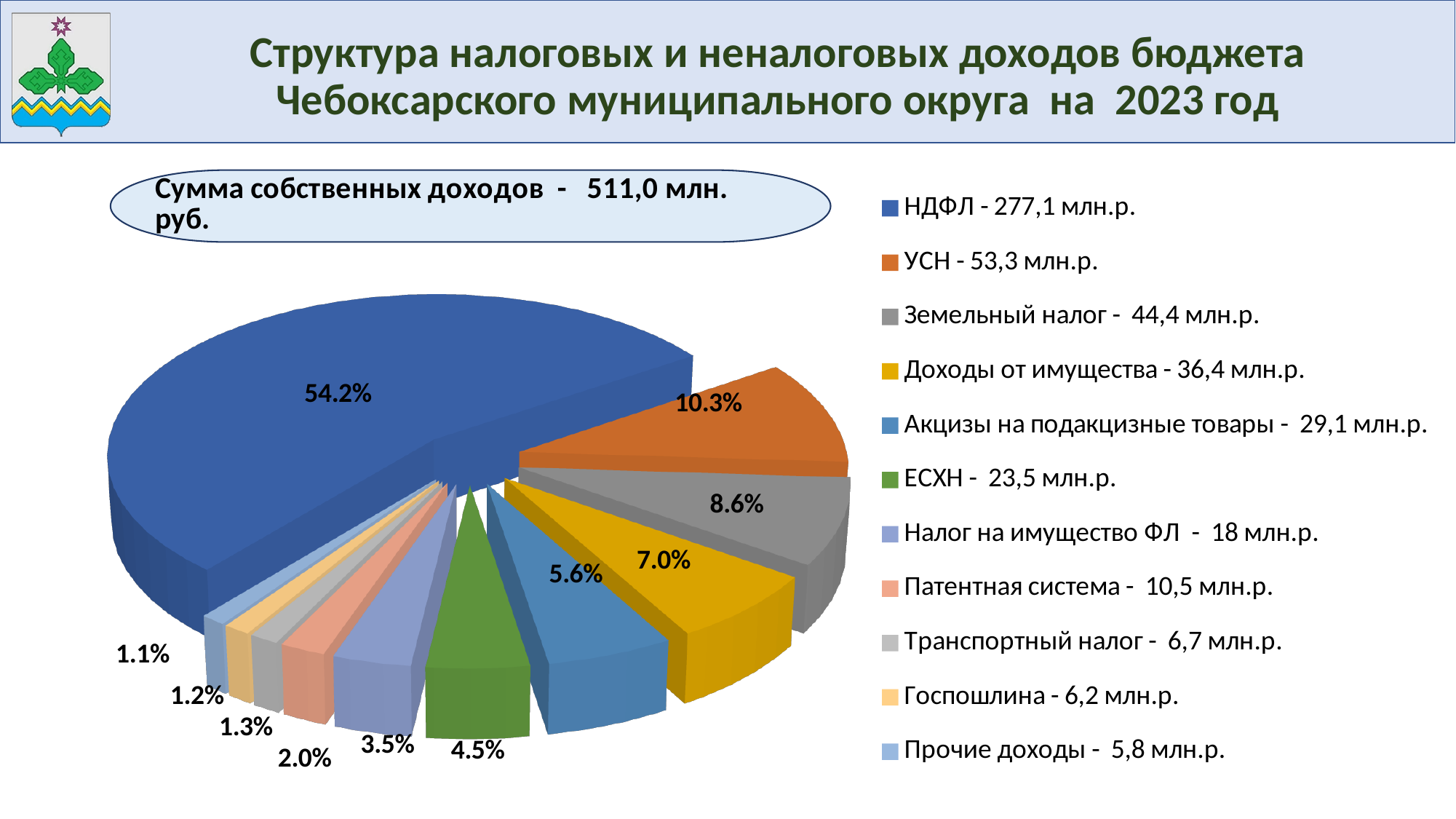
What is the difference between the values for НДФЛ and УСН shown in the legend? 223,8 млн.р. Which category has the smallest share of the pie? Прочие доходы According to the legend, what is the value for Акцизы на подакцизные товары? 29,1 млн.р. What kind of chart is shown on the slide? pie chart What total sum of own revenues is stated on the slide? 511,0 млн. руб. Which is larger, the share for Доходы от имущества or the share for Налог на имущество ФЛ? Доходы от имущества What share of the pie does УСН account for? 10.3% Which category has the largest share of the pie? НДФЛ How many slices does the pie chart have? 11 What share of the pie does ЕСХН account for? 4.5% According to the legend, what is the value for Земельный налог? 44,4 млн.р. What share of the pie does НДФЛ account for? 54.2%